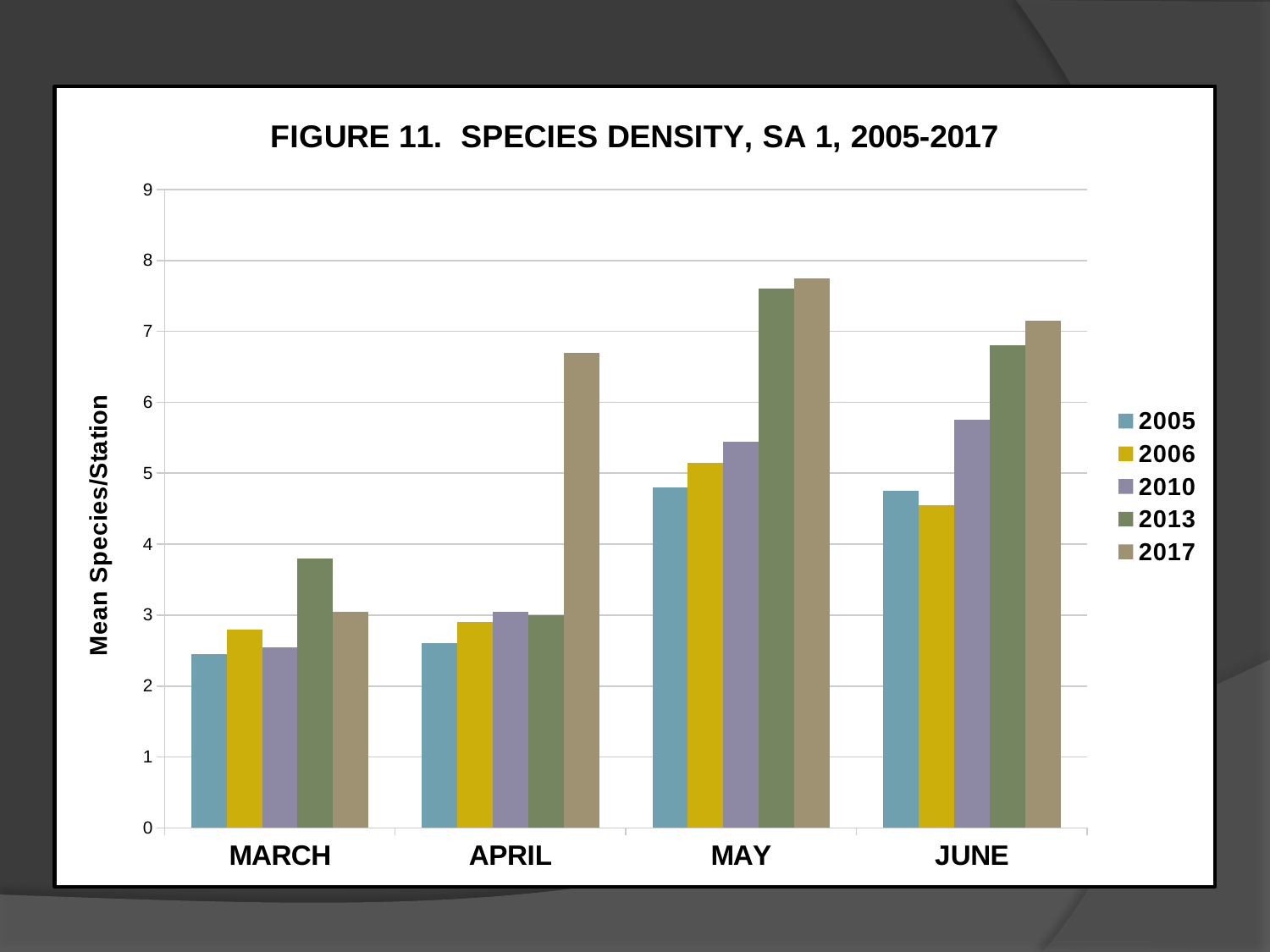
In JUNE, which year has the lowest mean species per station? 2006 What kind of chart is shown on the slide? bar chart Is the value for 2013 in MAY greater or less than 7? greater Is the value for 2005 in JUNE greater or less than 5? less What is the label on the y axis? Mean Species/Station In APRIL, which year has the highest mean species per station? 2017 Which is larger for 2013: the value in MAY or the value in JUNE? MAY How many months are shown on the x axis? 4 Is the value for 2017 in APRIL greater or less than 6? greater What is the title of the chart? FIGURE 11. SPECIES DENSITY, SA 1, 2005-2017 How many series does the legend list? 5 In MARCH, which year has the highest mean species per station? 2013